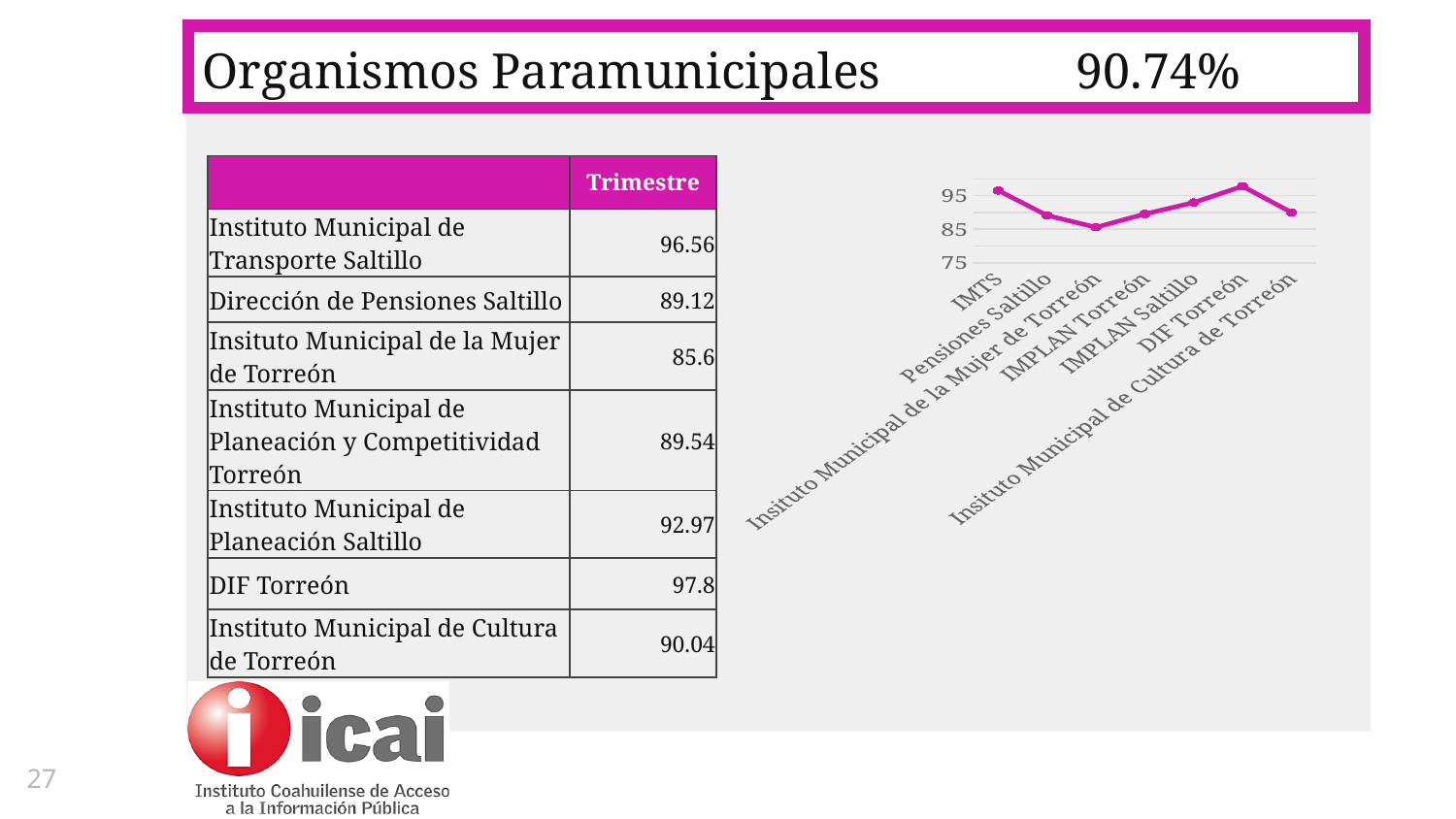
Is the value for Insituto Municipal de la Mujer de Torreón greater or less than 95? less According to the table, what is the Trimestre value for DIF Torreón? 97.8 What kind of chart is shown on the slide? line chart According to the table, what is the Trimestre value for Dirección de Pensiones Saltillo? 89.12 Which is larger in the line chart, the value for IMTS or the value for Pensiones Saltillo? IMTS Is the value for IMTS greater or less than 95? greater Which is larger in the line chart, the value for IMPLAN Saltillo or the value for IMPLAN Torreón? IMPLAN Saltillo Which organisation has the highest value in the line chart? DIF Torreón Which organisation has the lowest value in the line chart? Insituto Municipal de la Mujer de Torreón How many organisations are plotted along the x axis of the line chart? 7 Is the value for IMPLAN Torreón greater or less than 95? less What is the lowest tick value shown on the vertical axis of the line chart? 75